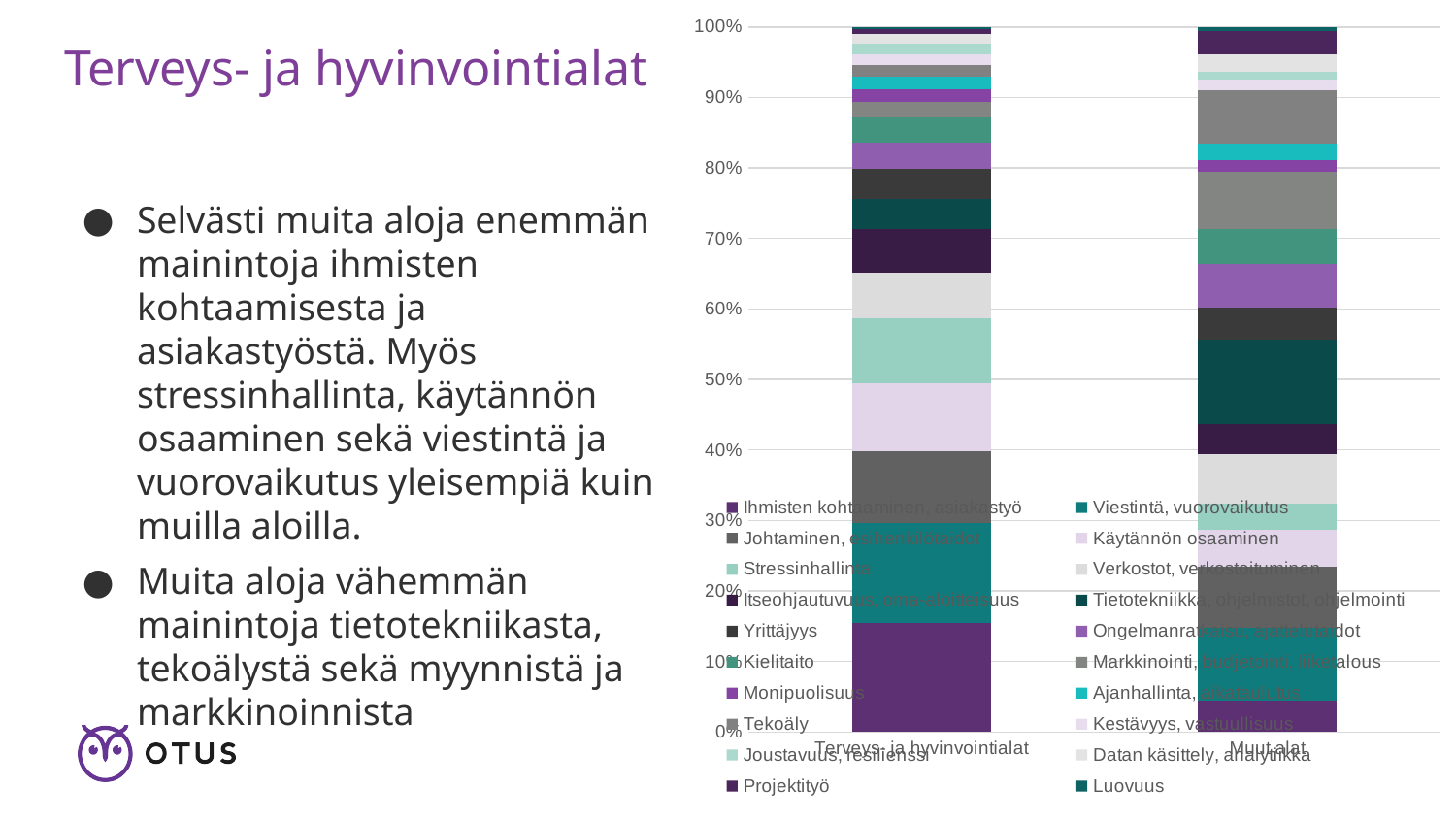
Is the share of Ihmisten kohtaaminen, asiakastyö in the Muut alat bar greater or less than 10%? less Which bar has the larger share for Stressinhallinta: Terveys- ja hyvinvointialat or Muut alat? Terveys- ja hyvinvointialat Is the share of Tietotekniikka, ohjelmistot, ohjelmointi in the Muut alat bar greater or less than 10%? greater Which bar has the larger share for Tietotekniikka, ohjelmistot, ohjelmointi: Terveys- ja hyvinvointialat or Muut alat? Muut alat How many categories are shown on the x axis of the chart? 2 What are the two categories on the x axis of the chart? Terveys- ja hyvinvointialat and Muut alat What is the total of the stacked bar for Terveys- ja hyvinvointialat? 100% Is the share of Ihmisten kohtaaminen, asiakastyö in the Terveys- ja hyvinvointialat bar greater or less than 10%? greater What kind of chart is shown on the slide? Stacked bar chart Which bar has the larger share for Ihmisten kohtaaminen, asiakastyö: Terveys- ja hyvinvointialat or Muut alat? Terveys- ja hyvinvointialat How many series does the chart's legend list? 20 What is the highest value shown on the chart's y axis? 100%